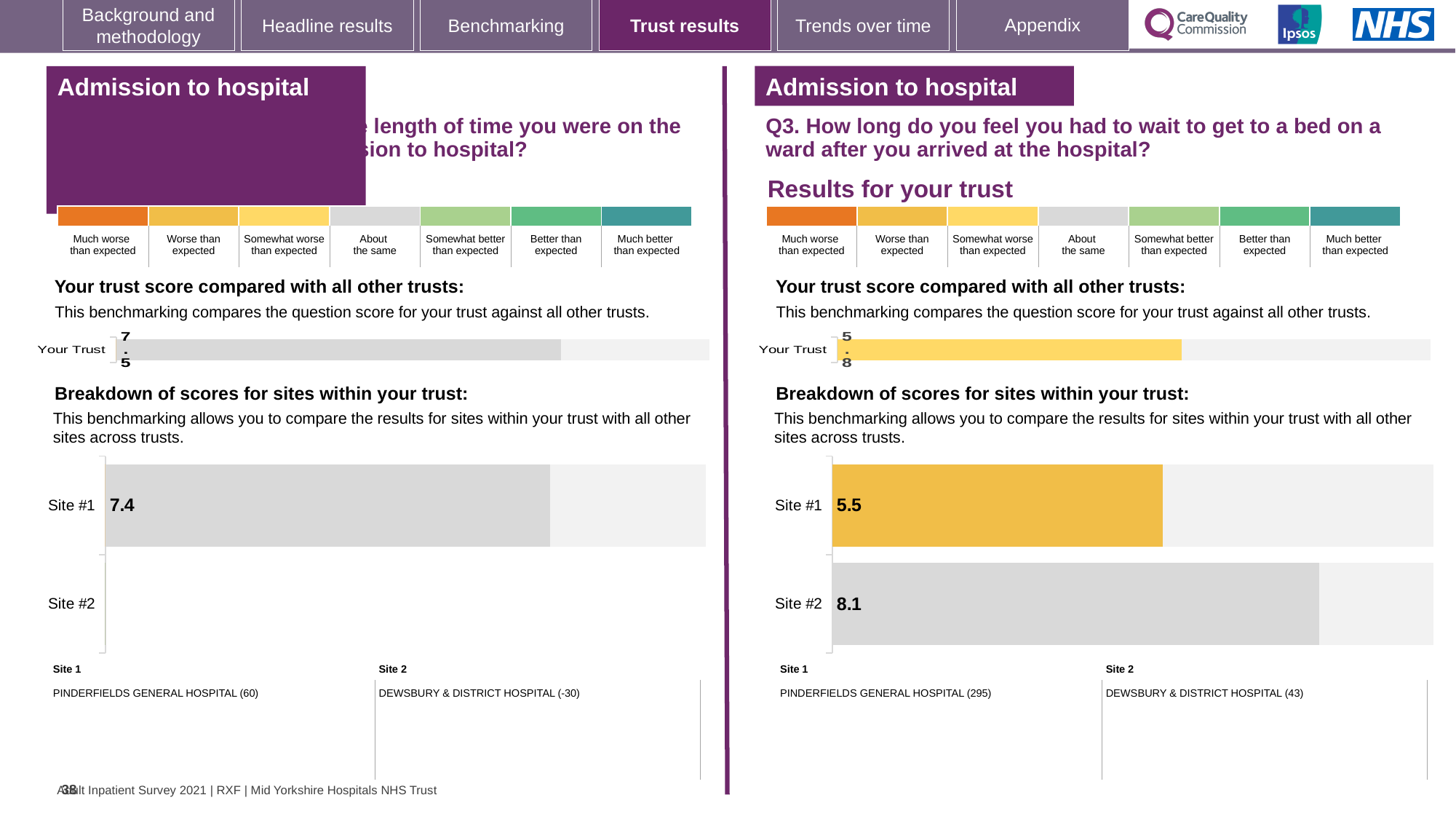
On the right-hand chart (Q3), what is the score shown for 'Your Trust'? 5.8 On the right-hand chart (Q3), what is the difference between the Site #2 score and the Site #1 score? 2.6 On the right-hand chart (Q3, wait to get to a bed on a ward), what is the score for Site #1? 5.5 On the right-hand chart (Q3), which site has the higher score, Site #1 or Site #2? Site #2 On the right-hand chart (Q3, wait to get to a bed on a ward), what is the score for Site #2? 8.1 On the right-hand chart (Q3), how many sites are listed in the site breakdown? 2 On the right-hand chart (Q3), which site has the lowest score? Site #1 On the left-hand chart, what is the score for Site #1? 7.4 What type of chart is used for the breakdown of scores for sites within the trust on the right-hand side? Bar chart On the right-hand chart (Q3), what colour is the Site #1 bar? Yellow On the left-hand chart, what is the score shown for 'Your Trust'? 7.5 On the right-hand chart (Q3), which hospital is Site 1? PINDERFIELDS GENERAL HOSPITAL (295)